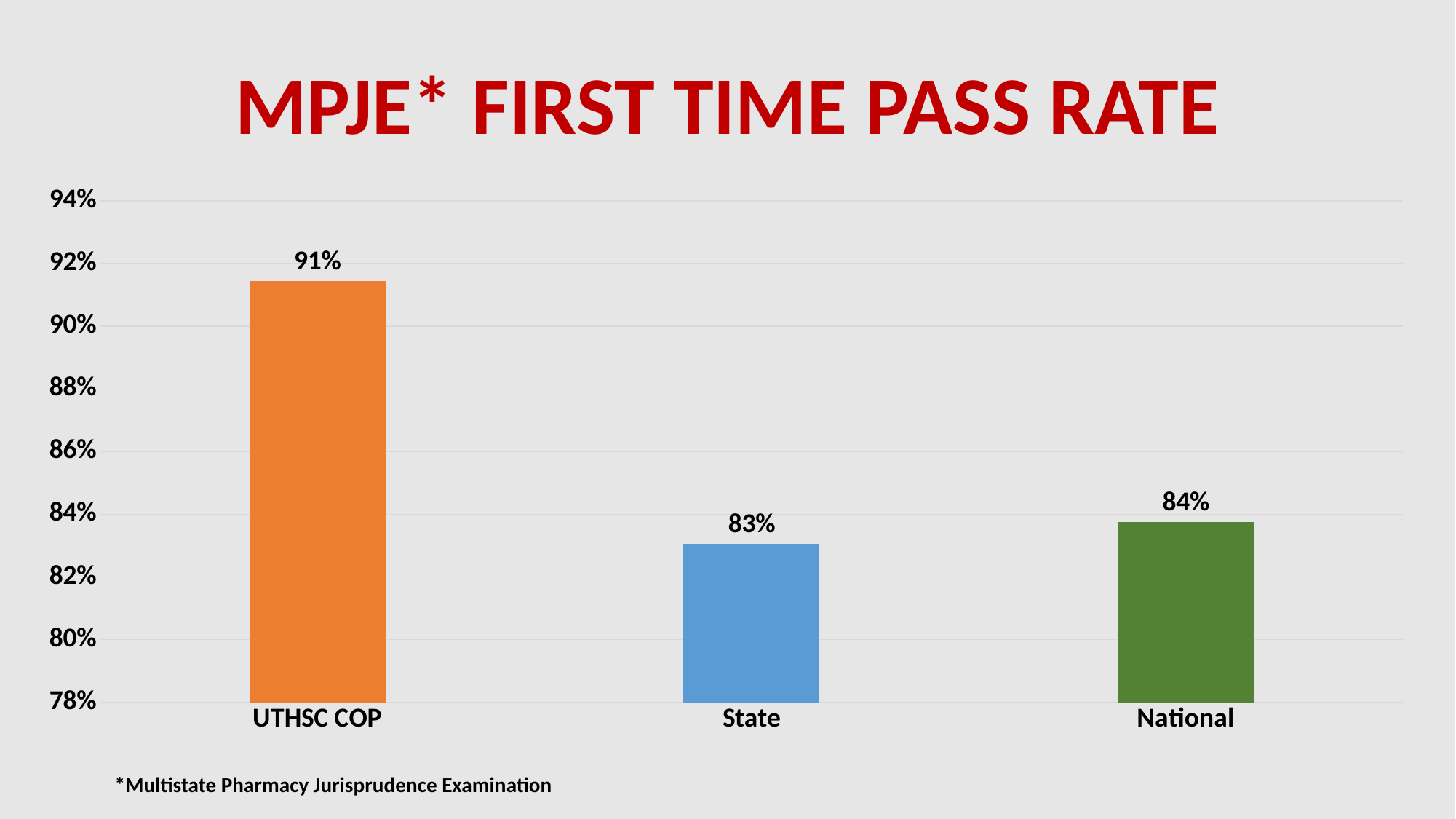
What is the MPJE first time pass rate for National? 84% What does the asterisk in the chart title MPJE stand for, according to the footnote? Multistate Pharmacy Jurisprudence Examination What is the difference between the National pass rate and the State pass rate? 1% What is the difference between the UTHSC COP pass rate and the National pass rate? 7% Is the value for UTHSC COP greater or less than 90%? greater Which category has the highest first time pass rate? UTHSC COP What is the MPJE first time pass rate for UTHSC COP? 91% Which is larger, the pass rate for UTHSC COP or for State? UTHSC COP What is the MPJE first time pass rate for State? 83% How many categories are shown in the chart? 3 Which category has the lowest first time pass rate? State What kind of chart is shown on the slide? Bar chart